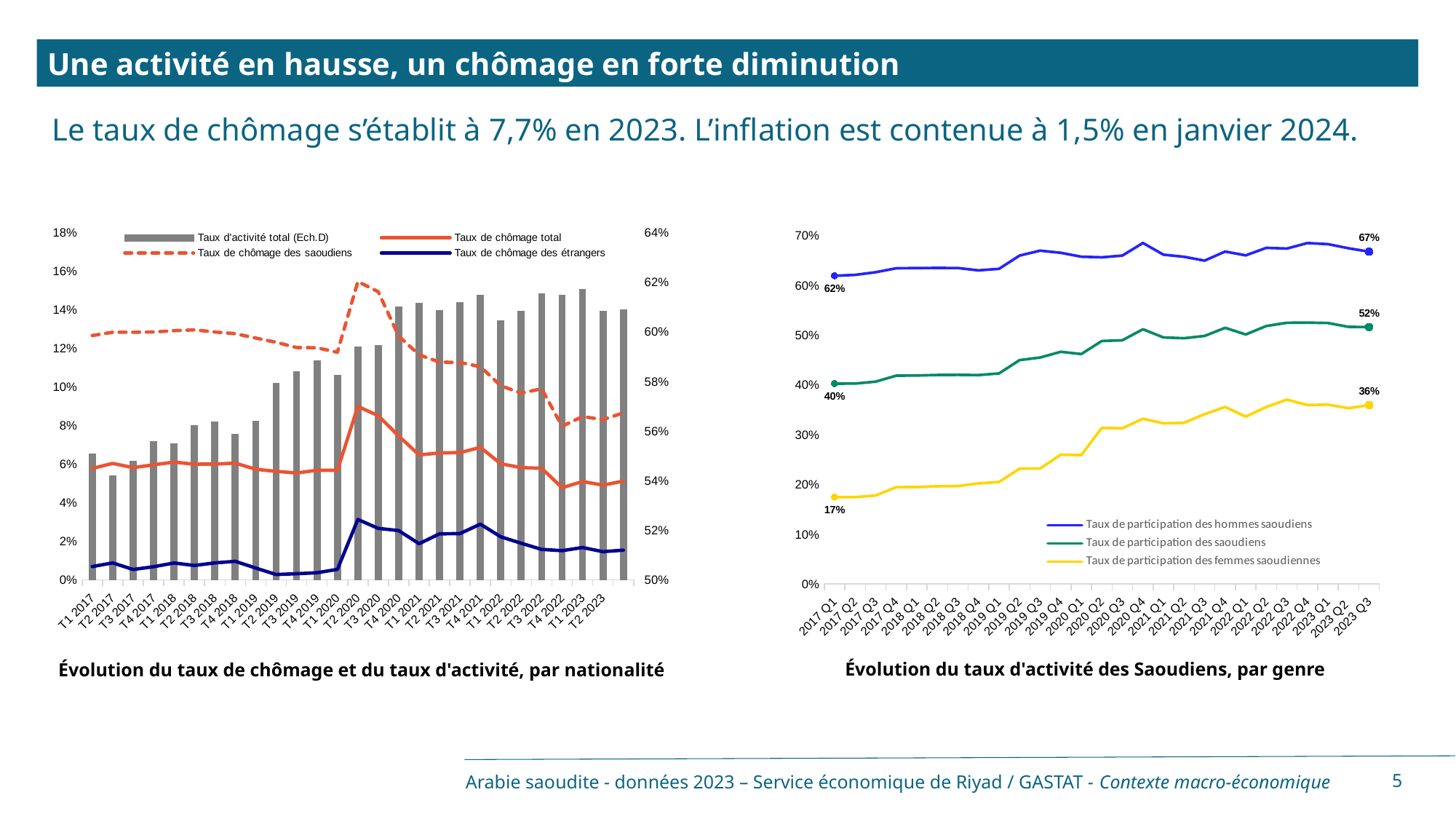
In the chart 'Évolution du taux d'activité des Saoudiens, par genre', what is the participation rate of Saudi women (femmes saoudiennes) in 2017 Q1? 17% In the chart 'Évolution du taux d'activité des Saoudiens, par genre', does the participation rate of Saudi women rise or fall from 2017 Q1 to 2023 Q3? It rises In the chart 'Évolution du taux d'activité des Saoudiens, par genre', by how much did the participation rate of Saudi women increase between 2017 Q1 and 2023 Q3? 19 percentage points In the chart 'Évolution du taux de chômage et du taux d'activité, par nationalité', is the value of 'Taux de chômage des saoudiens' in T2 2020 greater or less than 14%? greater In the chart 'Évolution du taux d'activité des Saoudiens, par genre', which series has the highest value in 2023 Q3? Taux de participation des hommes saoudiens In the chart 'Évolution du taux d'activité des Saoudiens, par genre', what is the participation rate of Saudis (saoudiens) in 2023 Q3? 52% What kind of chart is 'Évolution du taux d'activité des Saoudiens, par genre'? Line chart In the chart 'Évolution du taux d'activité des Saoudiens, par genre', what is the difference between the participation rate of Saudi men and Saudi women in 2023 Q3? 31 percentage points In the chart 'Évolution du taux de chômage et du taux d'activité, par nationalité', how many series does the legend list? 4 In the chart 'Évolution du taux d'activité des Saoudiens, par genre', how many series does the legend list? 3 In the chart 'Évolution du taux d'activité des Saoudiens, par genre', what is the participation rate of Saudi men (hommes saoudiens) in 2023 Q3? 67% In the chart 'Évolution du taux d'activité des Saoudiens, par genre', what is the participation rate of Saudi men in 2017 Q1? 62%